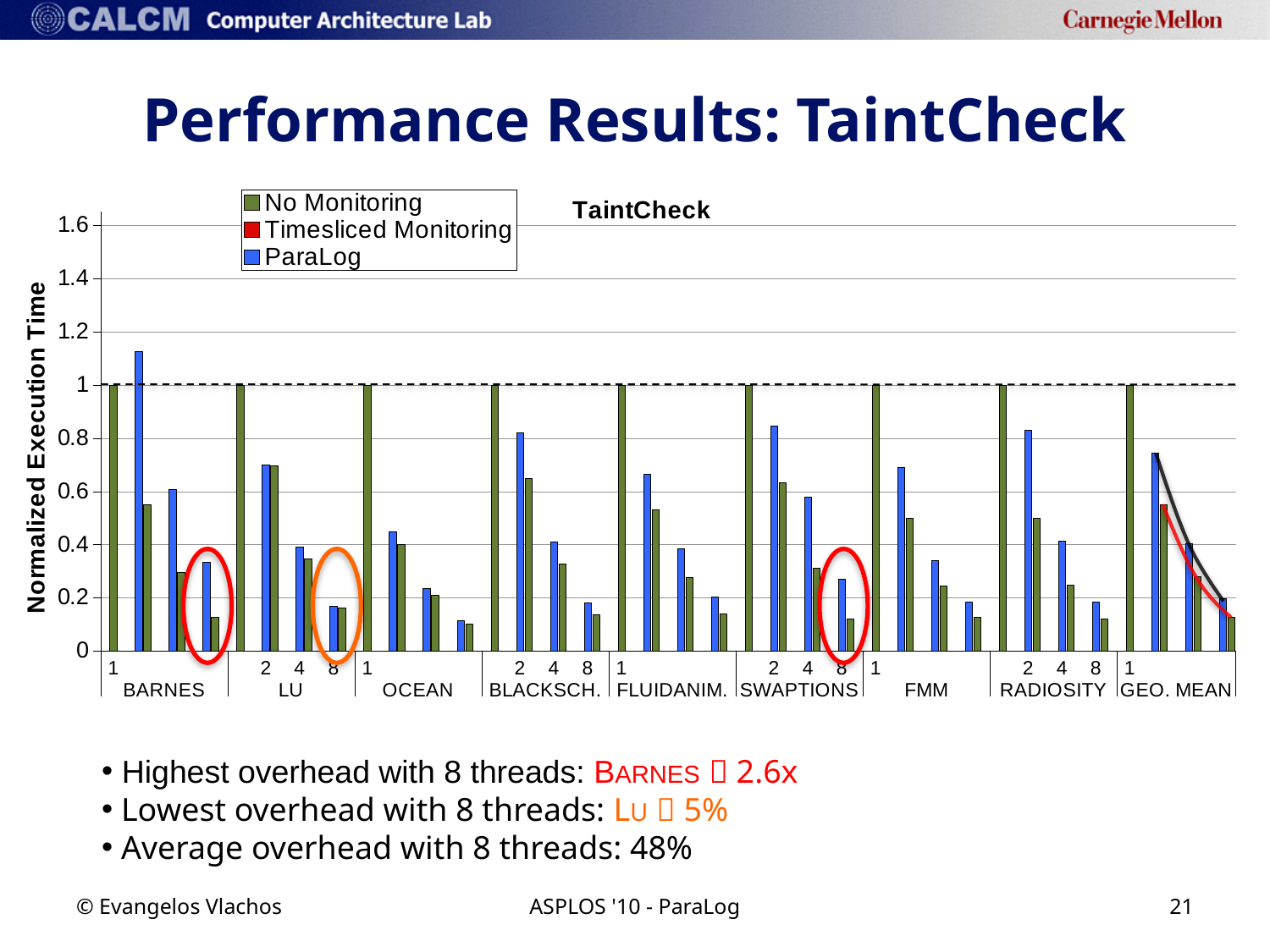
What kind of chart is shown on the slide? bar chart Is the ParaLog value for LU at 8 threads greater or less than 0.2? less What is the label of the y axis of the chart? Normalized Execution Time What is the title of the chart? TaintCheck Is the ParaLog value for SWAPTIONS at 2 threads greater or less than 0.8? greater How many series does the chart legend list? 3 What is the No Monitoring value for BARNES at 1 thread? 1 Within the BARNES group, do the ParaLog values rise or fall as the thread count increases from 1 to 8? fall For GEO. MEAN at 8 threads, which is larger: the ParaLog value or the No Monitoring value? ParaLog How many benchmark groups are shown along the x axis of the chart? 9